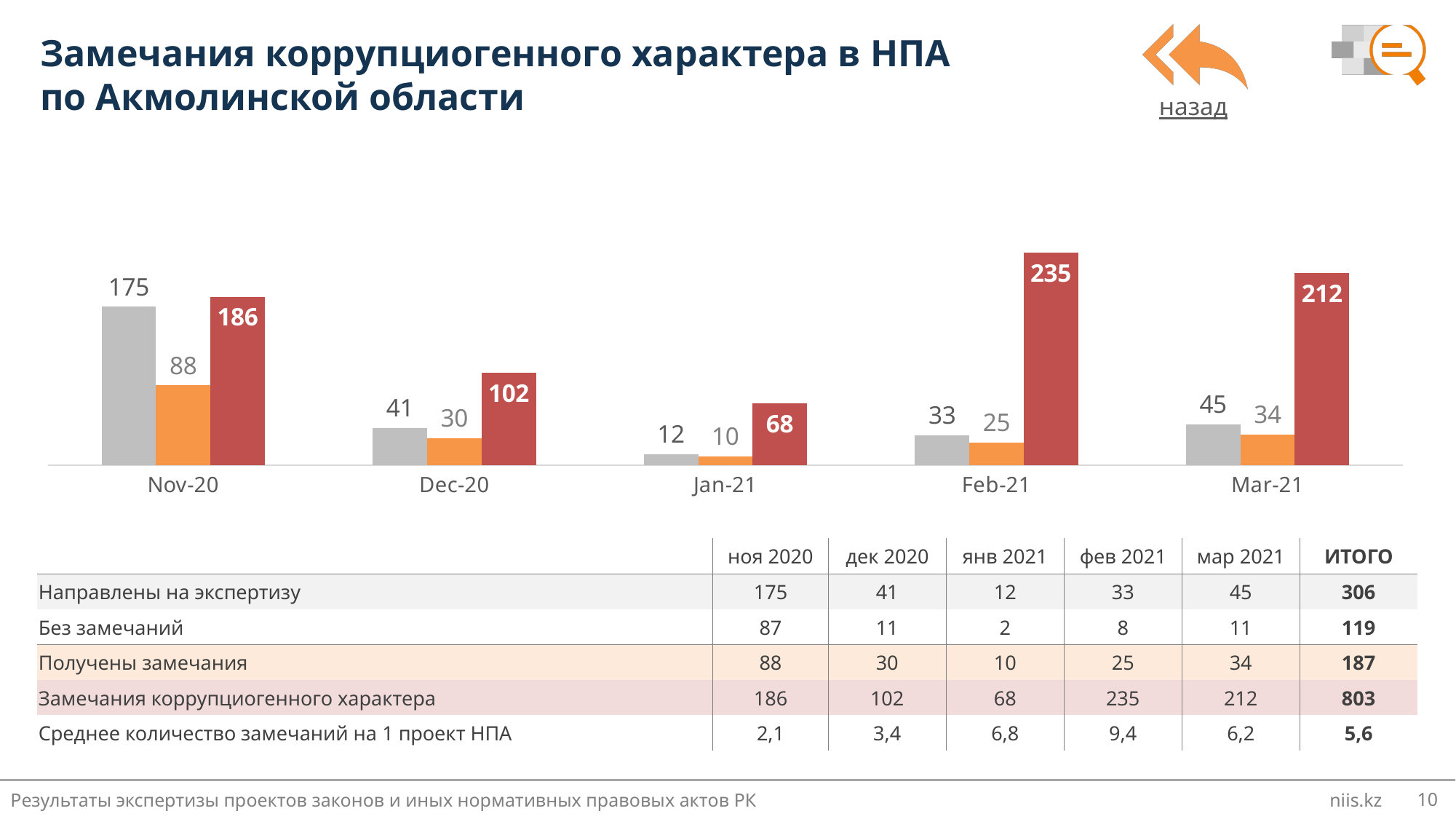
What is the value of the orange bar for Mar-21? 34 What is the value of the grey bar for Nov-20? 175 How many months are shown on the x axis of the chart? 5 What is the value of the red bar for Feb-21? 235 What type of chart is shown on the slide? bar chart What is the difference between the red bars for Feb-21 and Mar-21? 23 Does the grey bar rise or fall from Nov-20 to Jan-21? fall Which is larger for Dec-20: the grey bar or the red bar? the red bar How many bars are shown for each month in the chart? 3 Which month has the lowest grey bar? Jan-21 Which month has the highest red bar? Feb-21 What is the difference between the red bar and the grey bar for Nov-20? 11